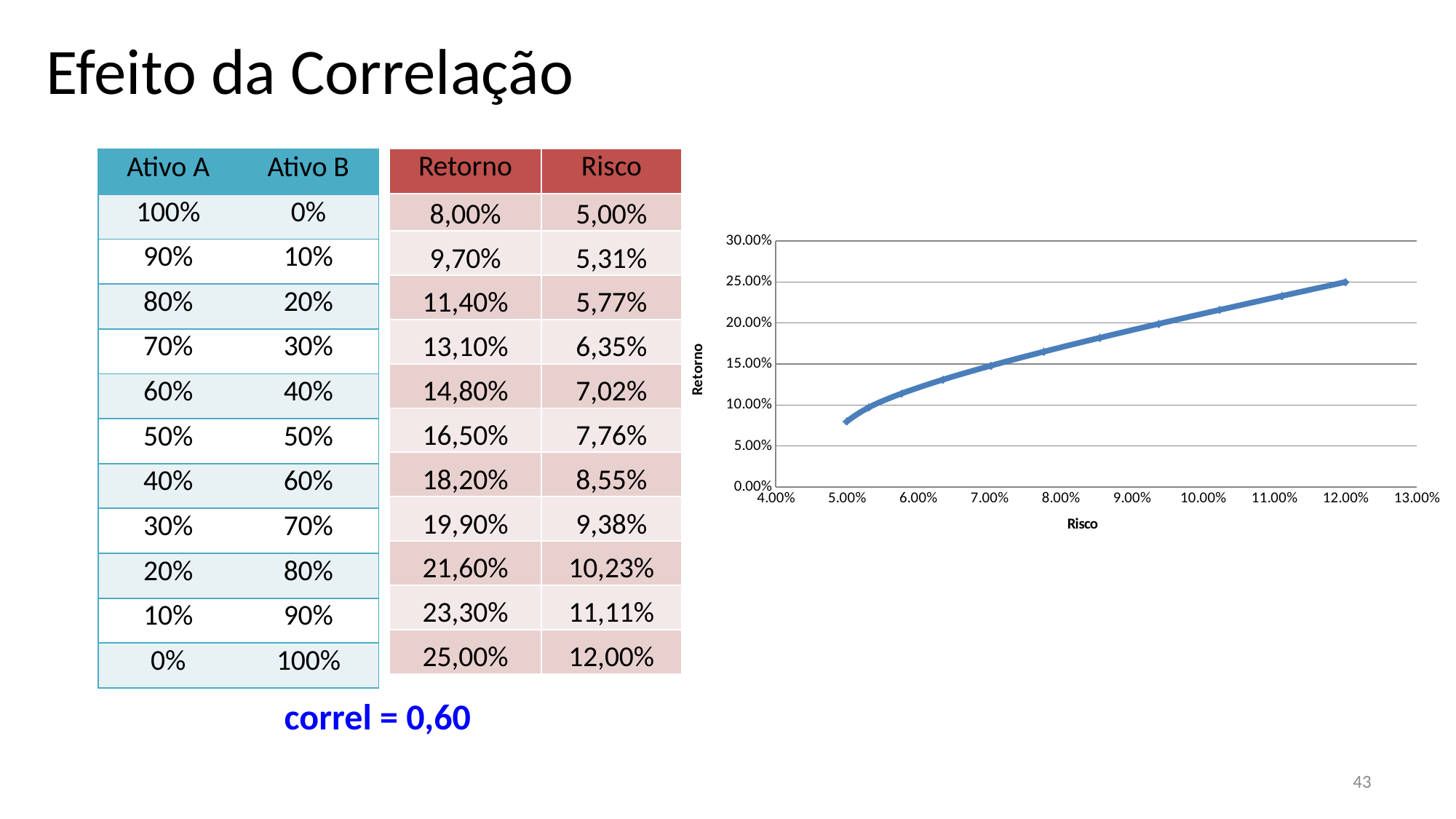
How many data points are plotted on the chart? 11 At what Risco value does the rightmost point of the line sit? 12.00% Is the Retorno value at a Risco of 9.00% greater or less than 20.00%? less At what Risco value does the leftmost point of the line sit? 5.00% What is the Retorno value of the rightmost point on the chart? 25.00% What kind of chart is shown on the slide? line chart Which point has the highest Retorno: the one at Risco 5.00% or the one at Risco 12.00%? Risco 12.00% Is the Retorno value at a Risco of 11.00% greater or less than 20.00%? greater What is the title of the x axis of the chart? Risco What is the title of the y axis of the chart? Retorno Does Retorno rise or fall as Risco increases along the x axis? rise Is the Retorno value at a Risco of 6.00% greater or less than 10.00%? greater